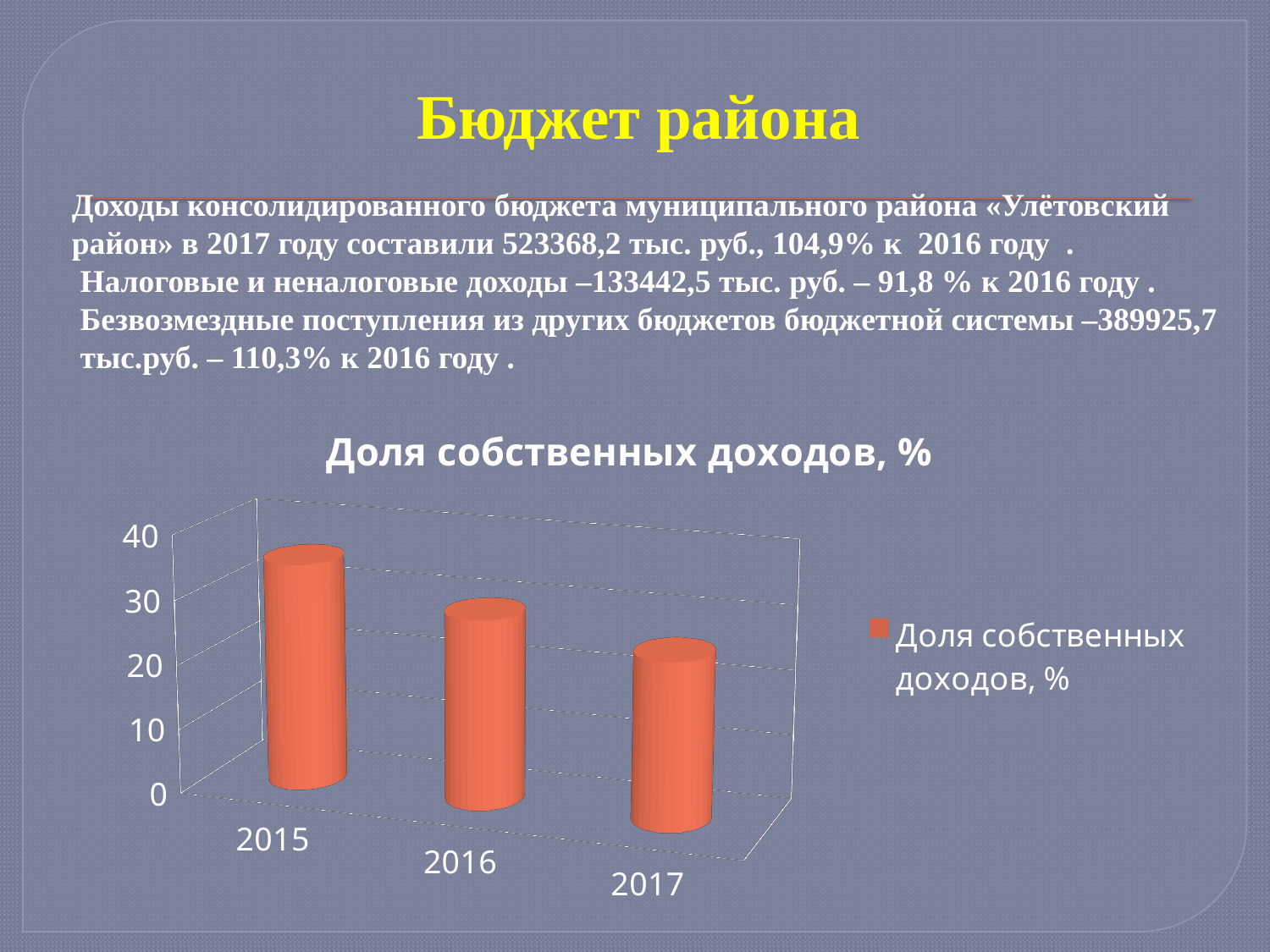
What is the legend entry shown next to the chart? Доля собственных доходов, % Is the value for 2017 greater or less than 30? less What is the title of the chart? Доля собственных доходов, % Is the value for 2016 greater or less than 20? greater Is the value for 2015 greater or less than 30? greater How many series does the chart legend list? 1 Which year has the highest share of own revenues in the chart? 2015 What kind of chart is shown on the slide? bar chart Which year has the lowest share of own revenues in the chart? 2017 Which is larger in the chart, the value for 2015 or the value for 2017? 2015 Do the values in the chart rise or fall from 2015 to 2017? fall How many years are shown on the x axis of the chart? 3